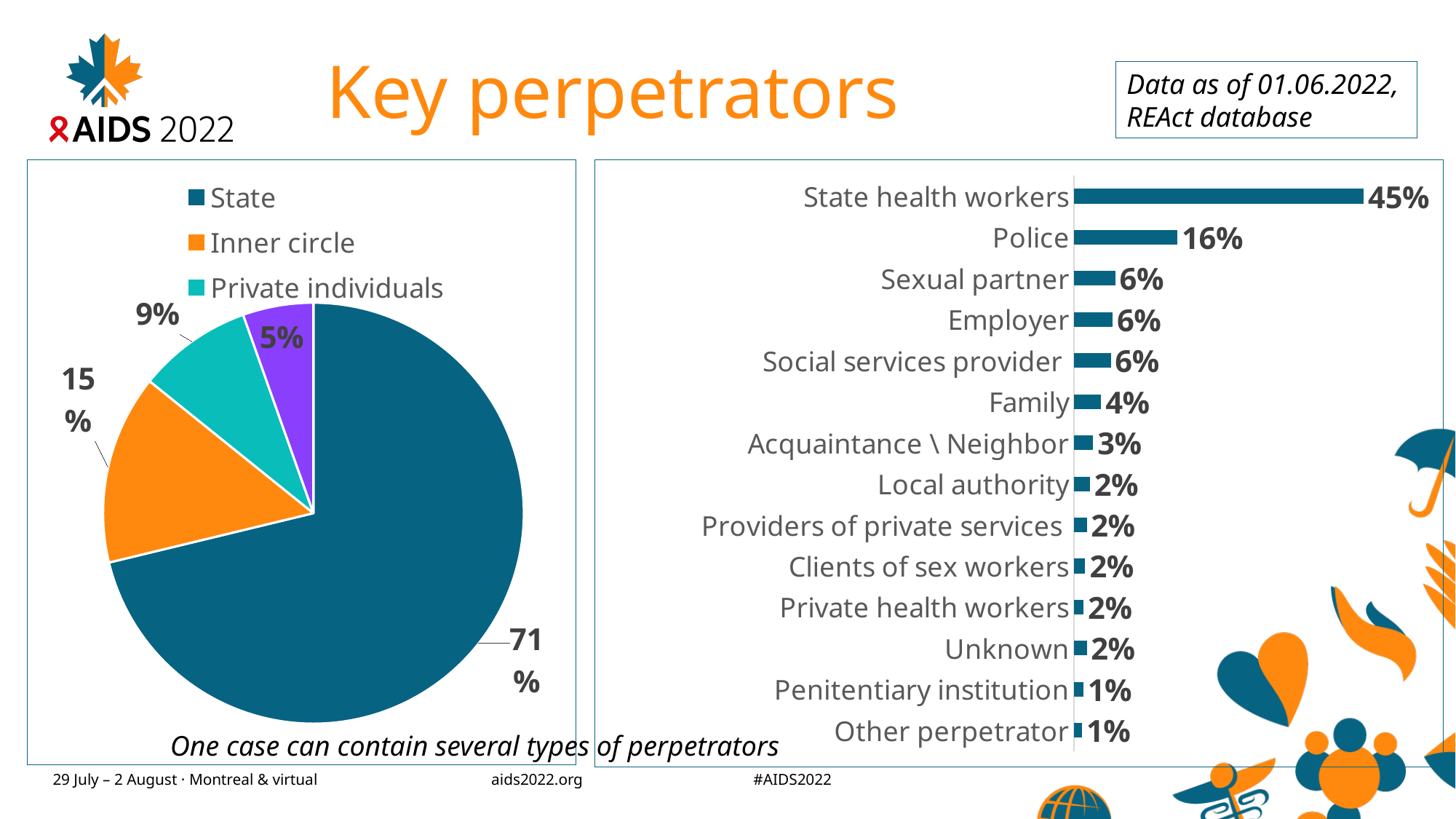
In the bar chart on the right, what is the value for Family? 4% In the pie chart on the left, what is the difference between the State share and the Inner circle share? 56% In the bar chart on the right, what is the value for Police? 16% In the pie chart on the left, which legend category has the largest slice? State In the bar chart on the right, which category has the highest value? State health workers In the bar chart on the right, what is the difference between the values for State health workers and Police? 29% In the pie chart on the left, what share is shown for Inner circle? 15% In the pie chart on the left, how many entries does the legend list? 3 In the bar chart on the right, how many categories are shown? 14 In the pie chart on the left, what share is shown for State? 71% In the bar chart on the right, what is the value for State health workers? 45% In the pie chart on the left, what share is shown for Private individuals? 9%